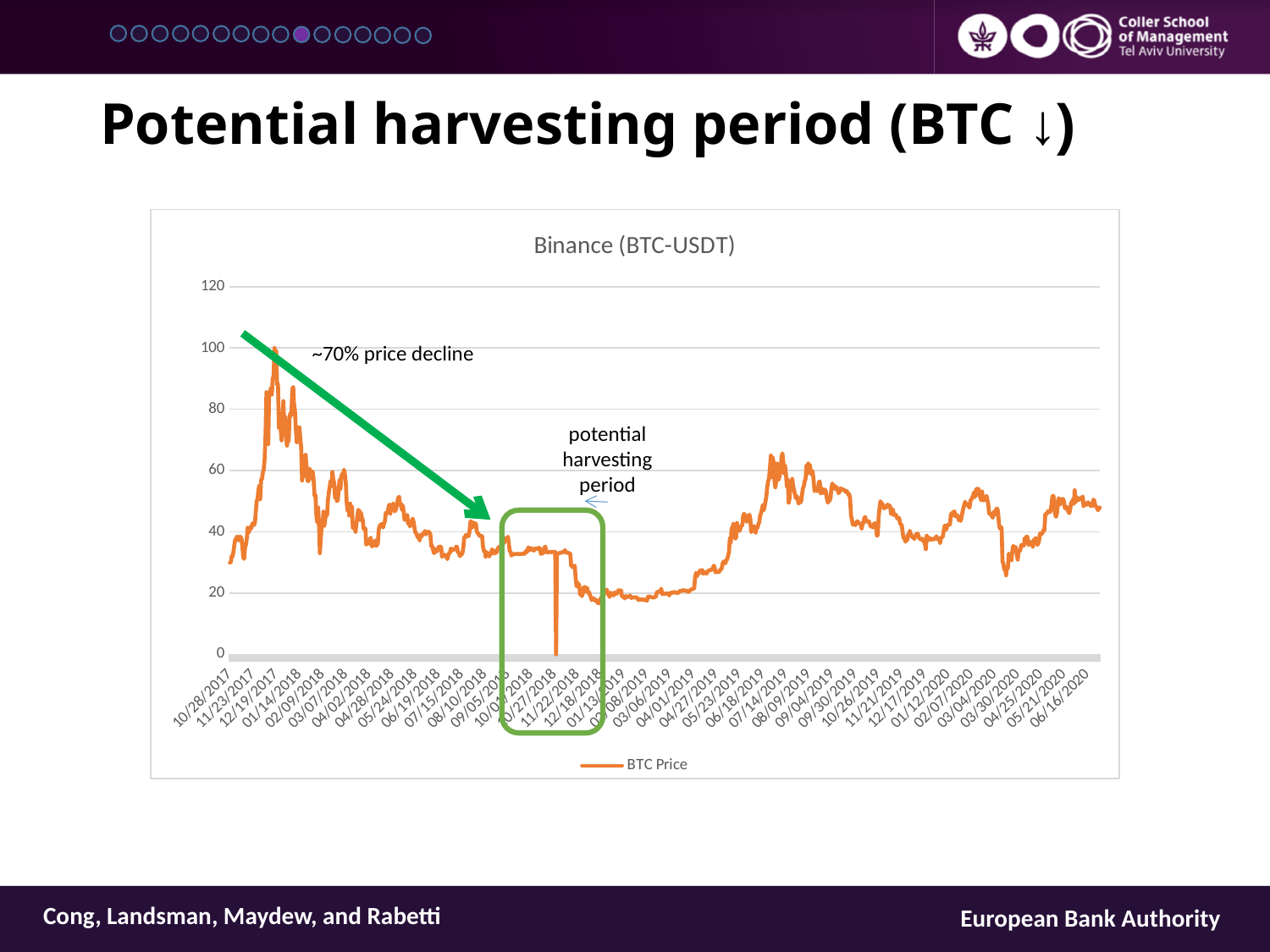
Does the BTC Price line rise or fall between 12/19/2017 and 12/18/2018? fall What kind of chart is shown on the slide? line chart What approximate price decline does the annotation on the chart state? ~70% price decline Is the BTC Price value at 07/14/2019 greater or less than 40? greater Is the BTC Price value at 06/16/2020 greater or less than 40? greater Is the BTC Price value at 03/30/2020 greater or less than 40? less Around which x-axis date label does the BTC Price line reach its highest value? 12/19/2017 How many series does the chart legend list? 1 What is the title of the chart? Binance (BTC-USDT) Which is larger, the BTC Price value at 12/19/2017 or at 06/16/2020? 12/19/2017